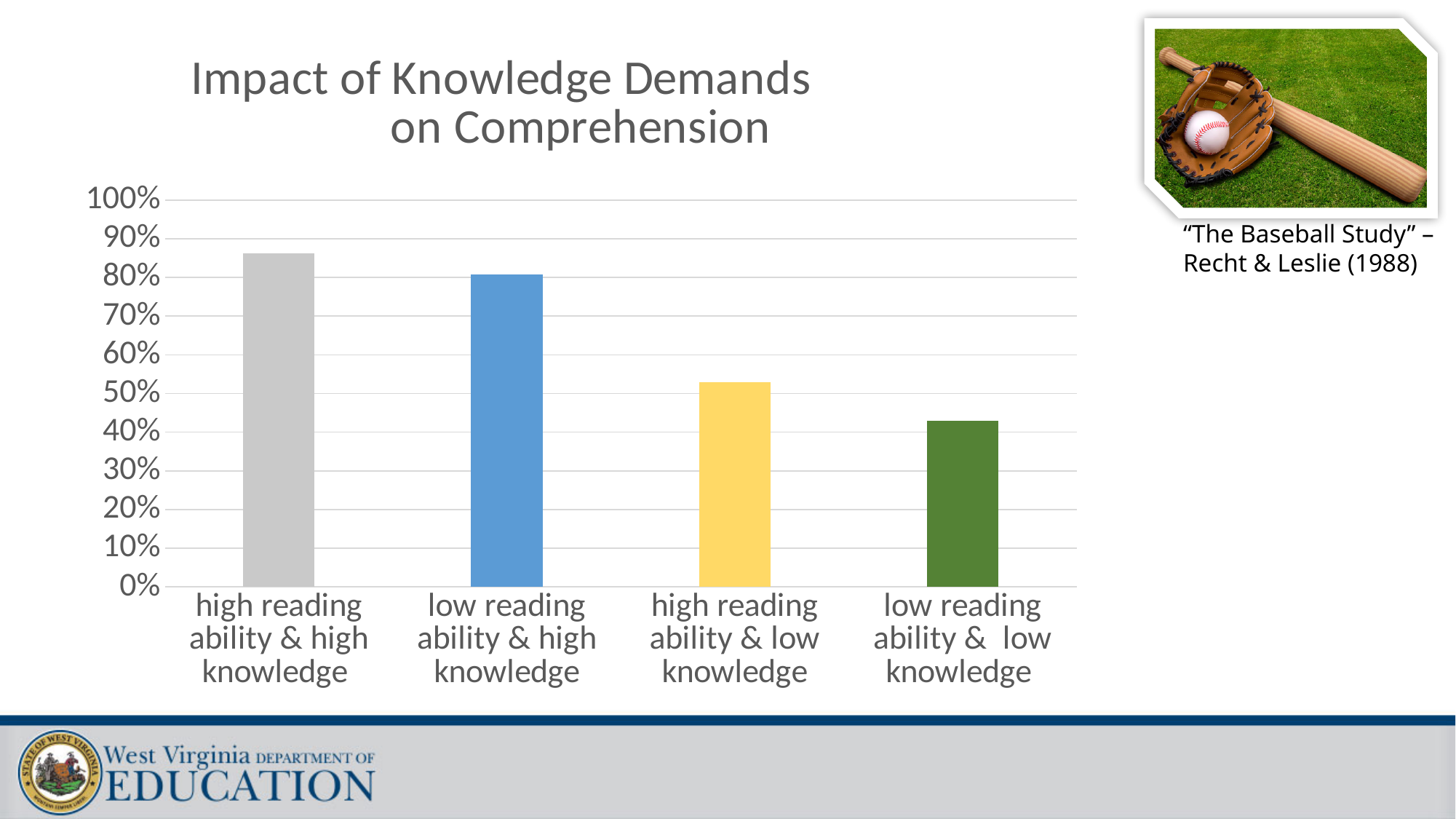
What kind of chart is shown on the slide? bar chart What is the title of the chart? Impact of Knowledge Demands on Comprehension Is the value for high reading ability & high knowledge greater or less than 80%? greater Is the value for low reading ability & low knowledge greater or less than 50%? less What colour is the bar for low reading ability & high knowledge? blue Which category has the highest bar? high reading ability & high knowledge Is the value for low reading ability & high knowledge greater or less than 90%? less How many categories are plotted in the chart? 4 Which category has the lowest bar? low reading ability & low knowledge Which is larger: the value for low reading ability & high knowledge or the value for high reading ability & low knowledge? low reading ability & high knowledge Do the bar values rise or fall from left to right across the categories? fall